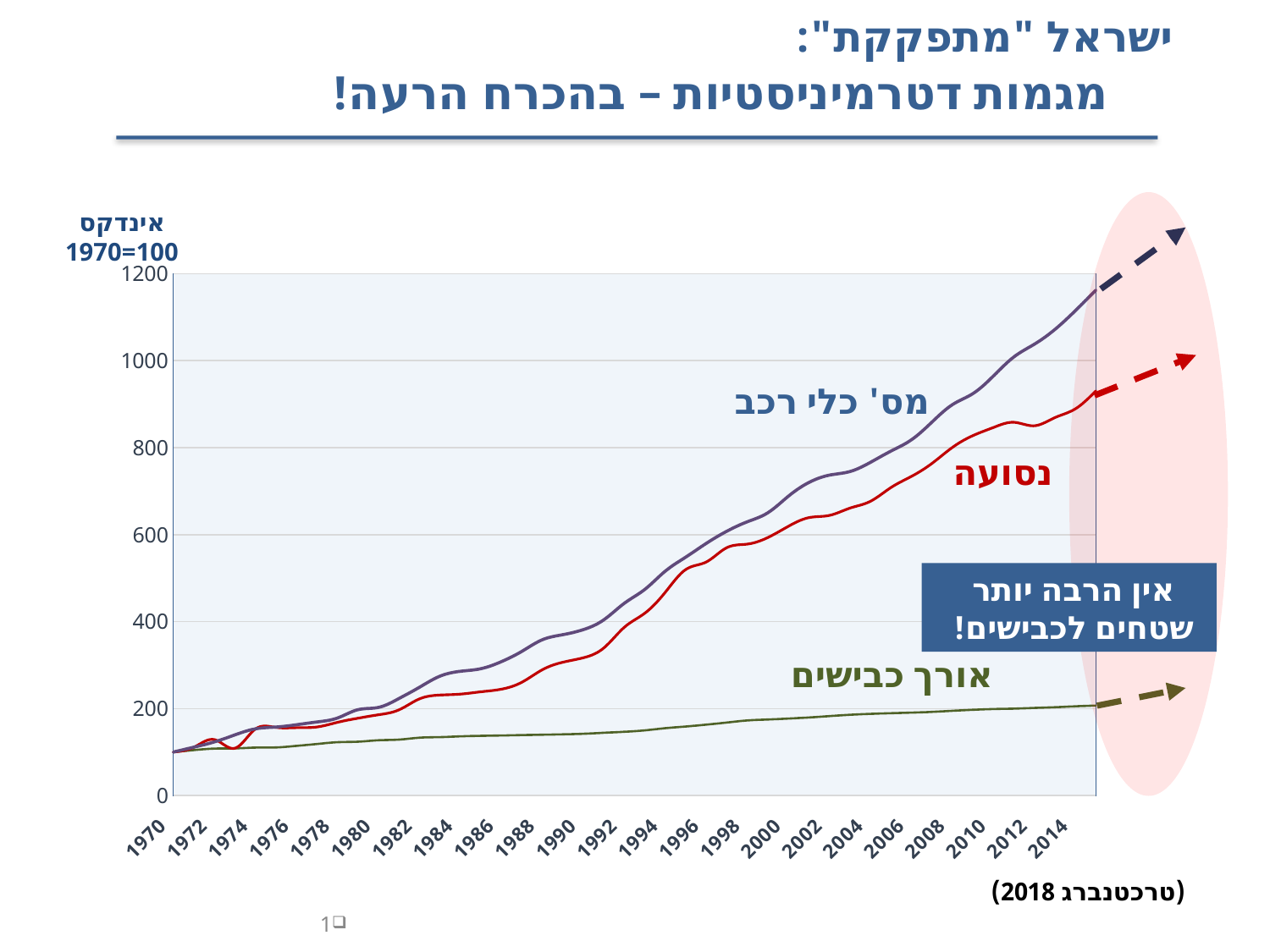
Is the value for מס' כלי רכב in 2014 greater or less than 1000? greater Which series has the lowest value by 2014? אורך כבישים Is the value for מס' כלי רכב in 1990 greater or less than 400? less Which series reaches the highest value by 2014? מס' כלי רכב How many data series are plotted on the chart? 3 Do the values for מס' כלי רכב rise or fall from 1970 to 2014? rise Is the value for נסועה in 2014 greater or less than 1000? less Which is larger in 2010, the value for מס' כלי רכב or the value for נסועה? מס' כלי רכב What kind of chart is shown on the slide? line chart What is the index value of all series in the base year 1970? 100 What base year and value does the index label above the chart state? 1970=100